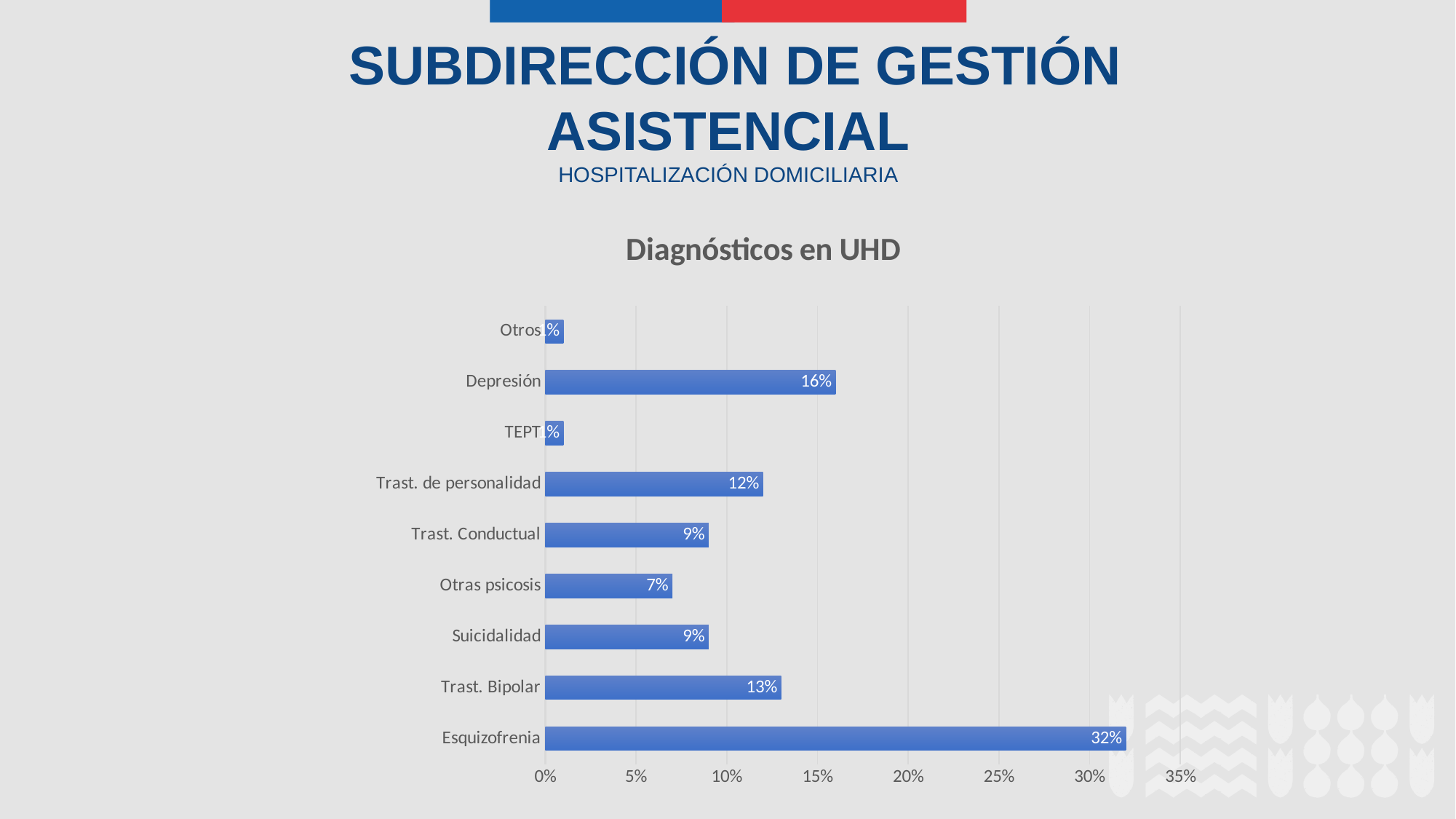
What is the value for Esquizofrenia? 32% What type of chart is shown on the slide? bar chart What is the difference between the values for Esquizofrenia and Depresión? 16% Which diagnosis has the highest value? Esquizofrenia What is the value for Depresión? 16% Which is larger, the value for Trast. de personalidad or the value for Trast. Bipolar? Trast. Bipolar What is the value for Trast. Bipolar? 13% What is the title of the chart? Diagnósticos en UHD What is the value for Otras psicosis? 7% What is the difference between the values for Trast. Conductual and Otras psicosis? 2% How many diagnosis categories are shown in the chart? 9 Is the value for TEPT greater or less than 5%? less